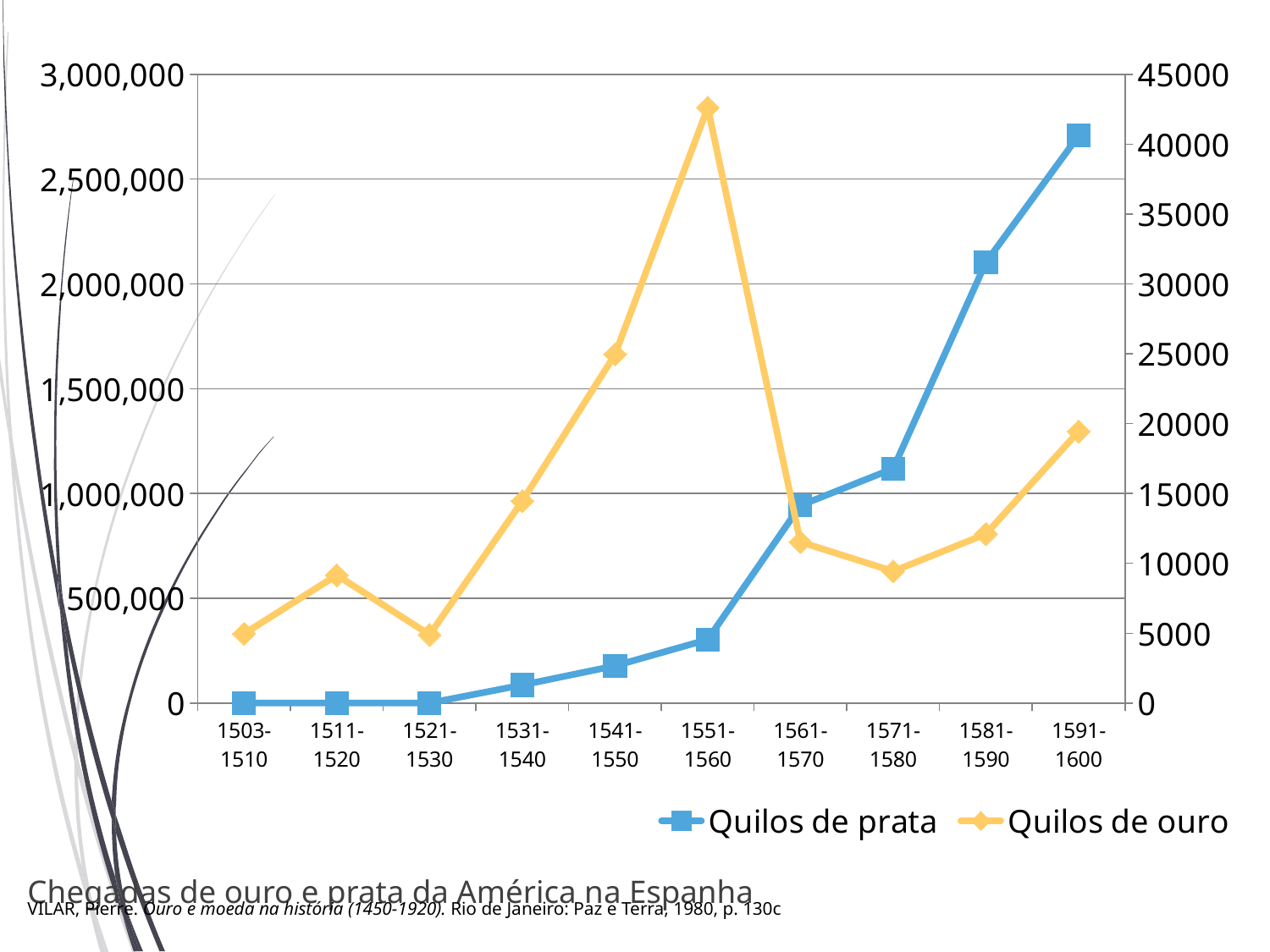
Does Quilos de prata generally rise or fall from 1503-1510 to 1591-1600? Rise What kind of chart is shown on the slide? Line chart Is the value of Quilos de prata for 1591-1600 greater or less than 2,500,000? greater Is the value of Quilos de ouro for 1541-1550 greater or less than 20000? greater Is the value of Quilos de ouro for 1551-1560 greater or less than 40000? greater In which period does Quilos de prata reach its highest value? 1591-1600 How many series does the legend list? 2 In which period does Quilos de ouro reach its highest value? 1551-1560 Which period has the larger value of Quilos de ouro, 1541-1550 or 1551-1560? 1551-1560 What are the two series named in the legend? Quilos de prata and Quilos de ouro How many time periods are shown on the x axis? 10